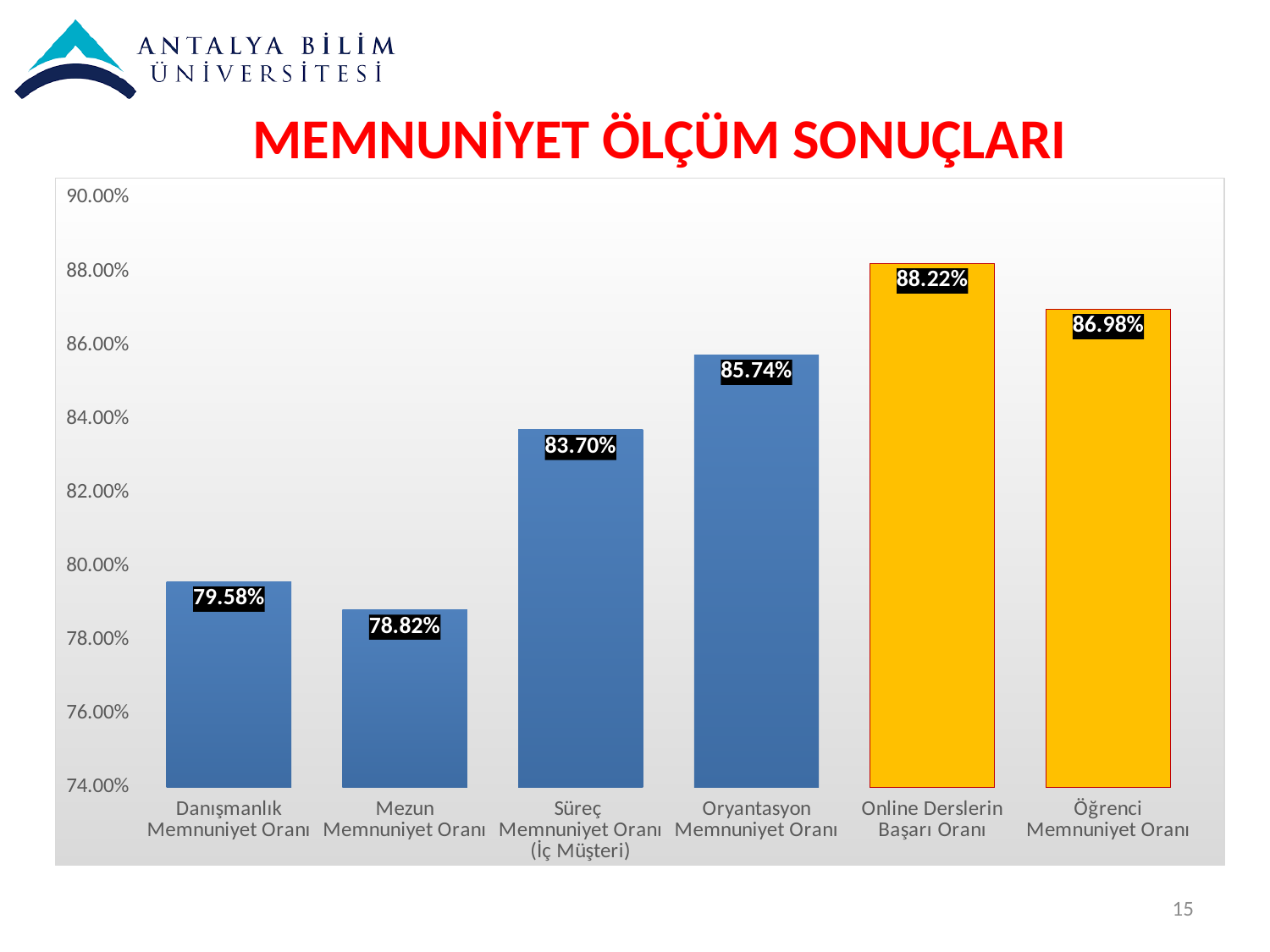
Is the value for Mezun Memnuniyet Oranı greater or less than 80.00%? less Which is larger, Oryantasyon Memnuniyet Oranı or Süreç Memnuniyet Oranı (İç Müşteri)? Oryantasyon Memnuniyet Oranı How many bars are coloured yellow? 2 What is the value for Süreç Memnuniyet Oranı (İç Müşteri)? 83.70% Which category has the highest value? Online Derslerin Başarı Oranı What is the difference between Online Derslerin Başarı Oranı and Öğrenci Memnuniyet Oranı? 1.24% How many categories are shown in the chart? 6 Which category has the lowest value? Mezun Memnuniyet Oranı What is the value for Danışmanlık Memnuniyet Oranı? 79.58% What is the title of the slide? MEMNUNİYET ÖLÇÜM SONUÇLARI What is the value for Online Derslerin Başarı Oranı? 88.22% What kind of chart is shown on the slide? bar chart